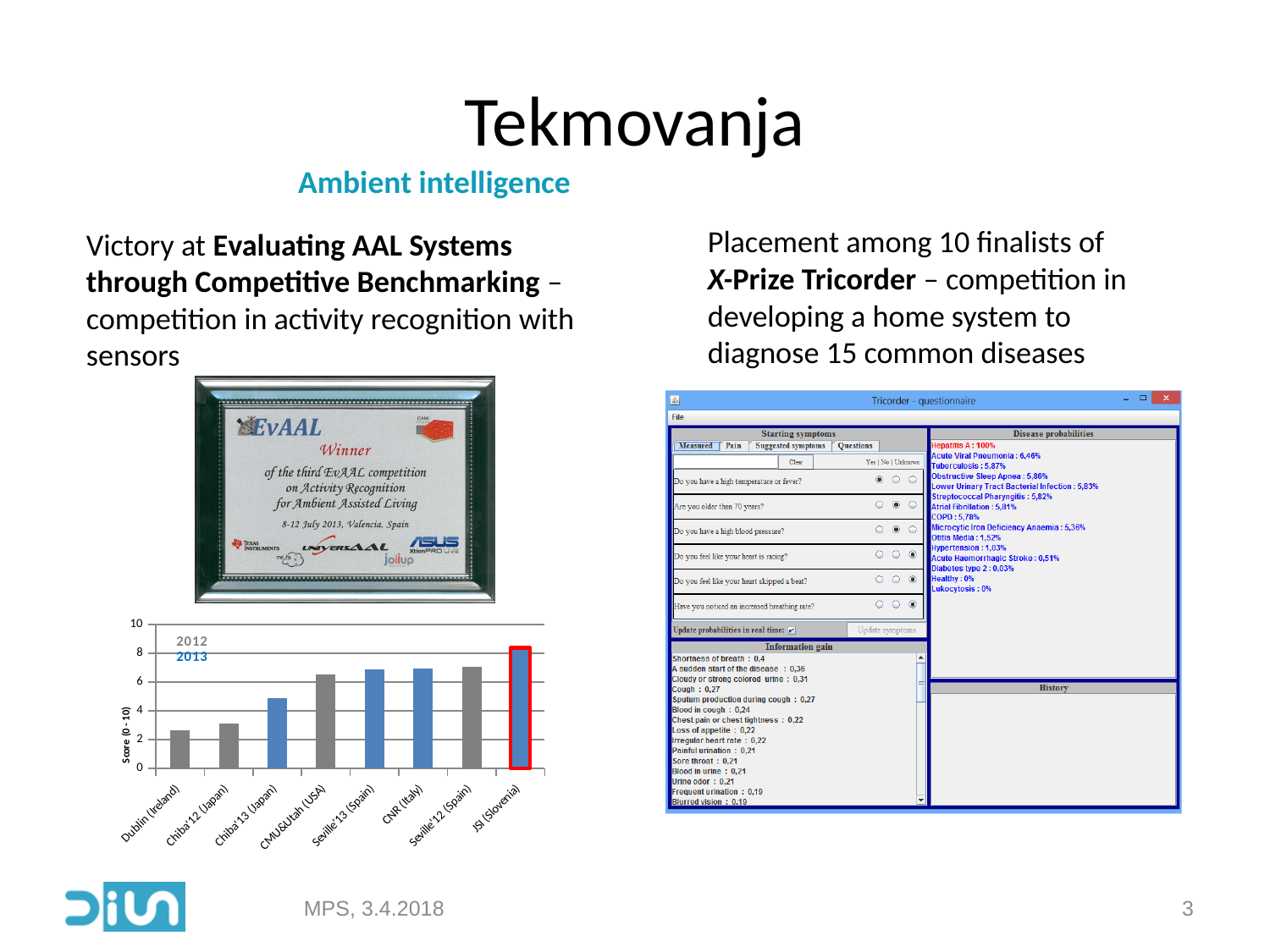
What is the title of the y axis of the bar chart? Score (0 - 10) Is the score for Dublin (Ireland) greater or less than 4? less Is the score for JSI (Slovenia) greater or less than 8? greater Which two years are listed as series labels in the bar chart? 2012 and 2013 Do the scores in the bar chart generally rise or fall from left to right along the x axis? rise How many categories (teams) are shown on the x axis of the bar chart? 8 What kind of chart is shown at the bottom left of the slide? bar chart Is the score for CMU&Utah (USA) greater or less than 6? greater Which team has the lowest score in the bar chart? Dublin (Ireland) Which team has the highest score in the bar chart? JSI (Slovenia) Which has a higher score, CMU&Utah (USA) or Chiba'13 (Japan)? CMU&Utah (USA)